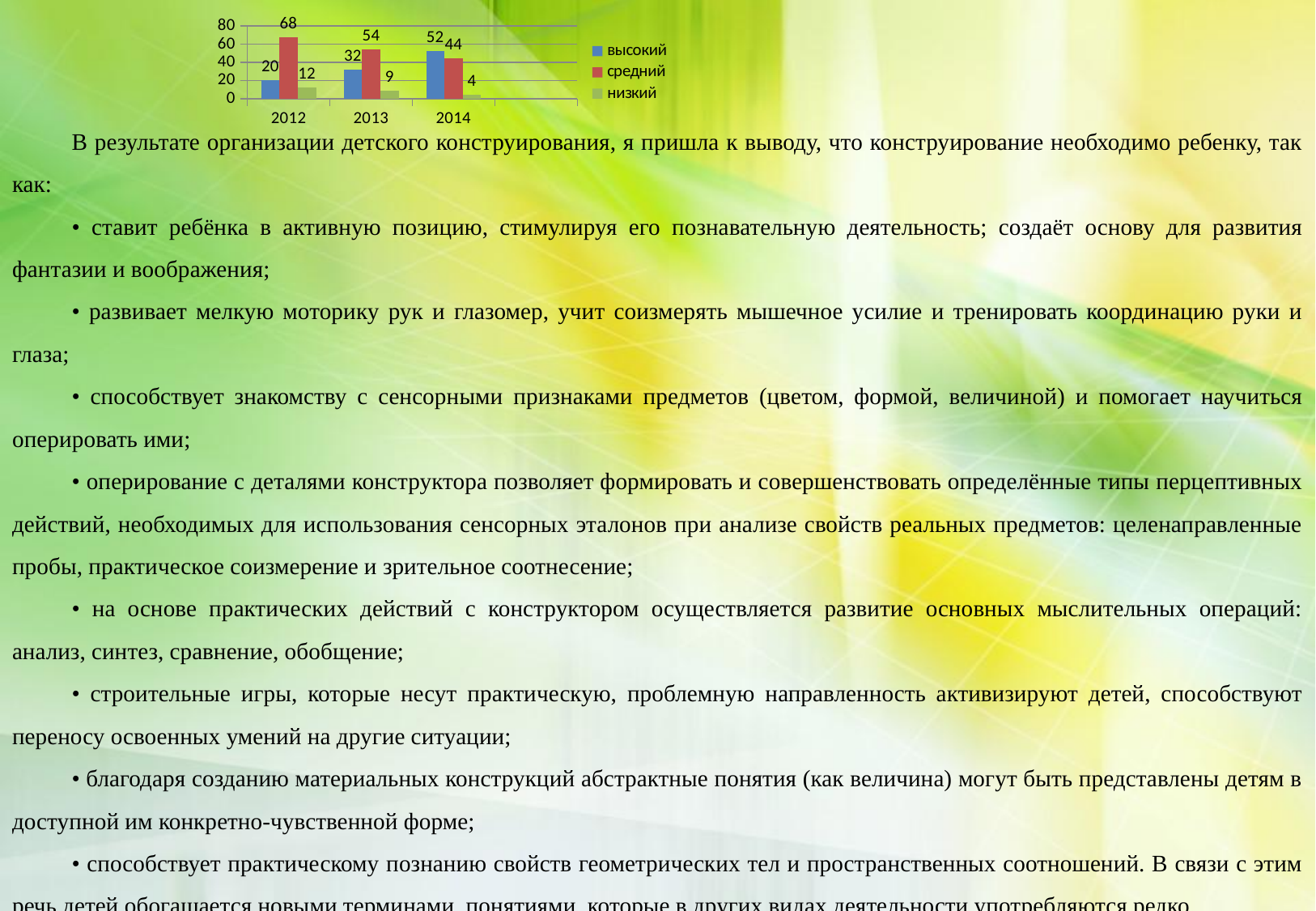
In which year is the value for высокий the highest? 2014 What is the value for средний in 2013? 54 In which year is the value for низкий the lowest? 2014 What is the value for низкий in 2014? 4 What is the difference between the средний values for 2012 and 2014? 24 Which is larger in 2014, высокий or средний? высокий What is the value for высокий in 2012? 20 How many years are shown on the x axis? 3 What type of chart is shown on the slide? bar chart How many series does the legend list? 3 Which colour represents the series средний in the chart? red Does the value for высокий rise or fall from 2012 to 2014? rise